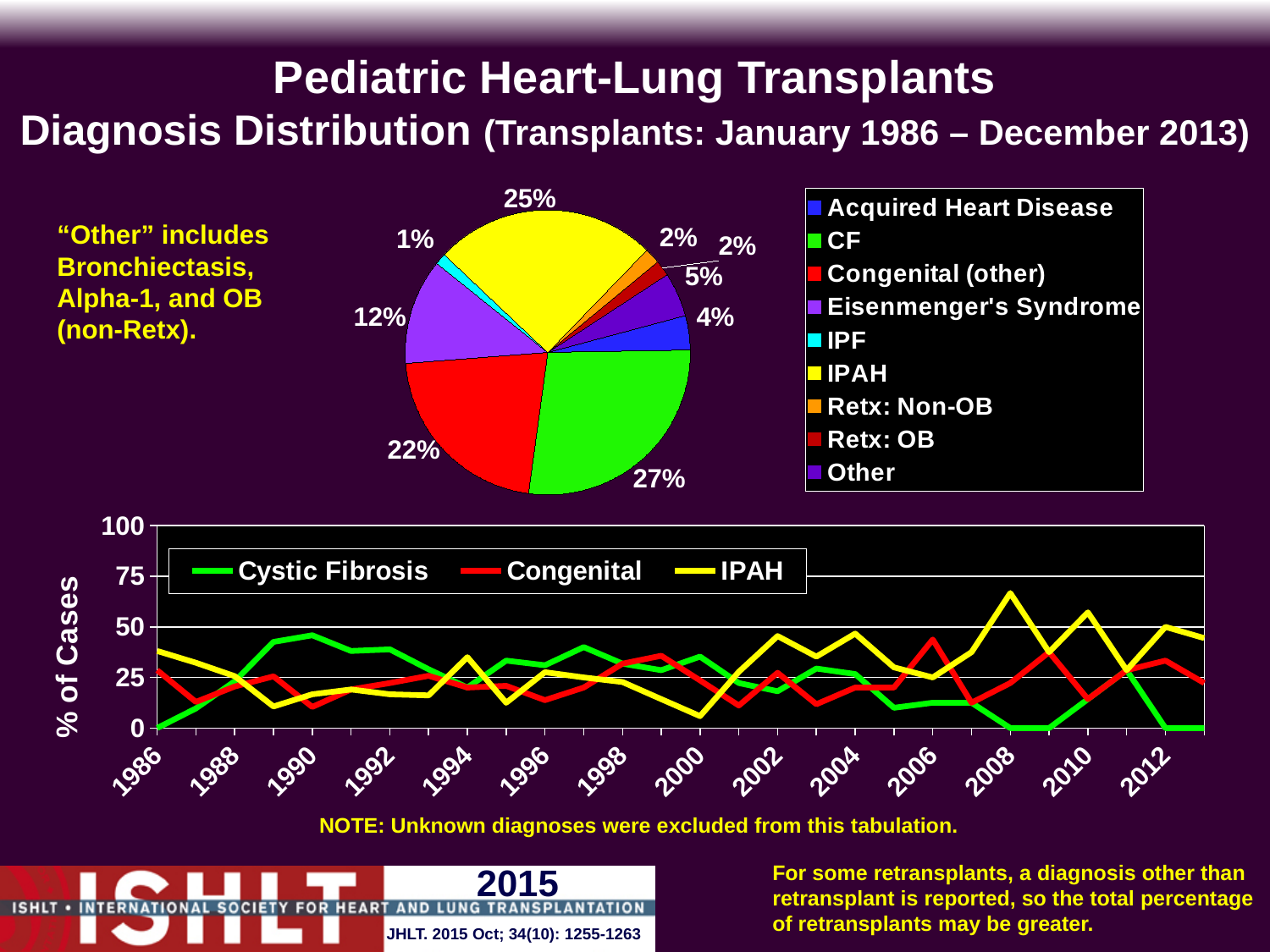
In the bottom line chart, is the value for IPAH in 2008 greater or less than 50? greater How many diagnosis categories does the pie chart's legend list? 9 In the pie chart, which diagnosis has the largest share? CF In the pie chart, what is the difference in percentage points between CF and Congenital (other)? 5 What kind of chart is the bottom chart showing % of Cases by year? Line chart In the pie chart, which is larger: the share for IPAH or the share for Eisenmenger's Syndrome? IPAH In the pie chart, which diagnosis has the smallest share? IPF In the pie chart, what percentage is shown for Eisenmenger's Syndrome? 12% In the pie chart, what percentage is shown for IPAH? 25% How many series does the legend of the bottom line chart list? 3 In the pie chart, what percentage of pediatric heart-lung transplants had a diagnosis of CF? 27% In the pie chart, what percentage is shown for Acquired Heart Disease? 4%